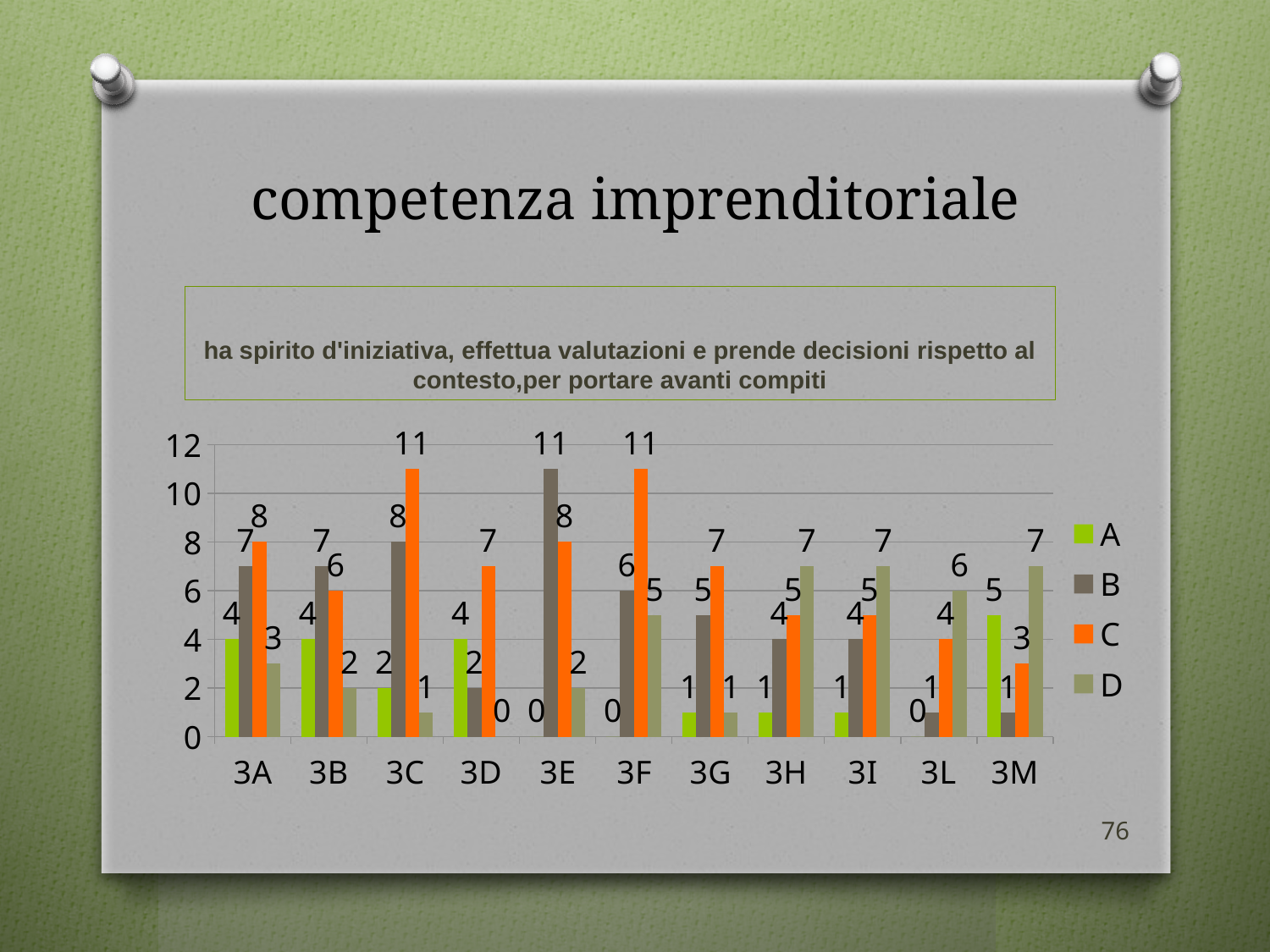
Which category has the highest value for series B? 3E How many categories are shown on the x axis? 11 What is the difference between series C and series A for 3A? 4 What kind of chart is shown on the slide? bar chart What is the title of the slide containing the chart? competenza imprenditoriale What is the value of series C for 3C? 11 What is the value of series A for 3M? 5 How many series does the legend list? 4 What is the value of series D for 3L? 6 Which category has the lowest value for series D? 3D For 3H, which is larger: series C or series D? D What is the value of series B for 3E? 11